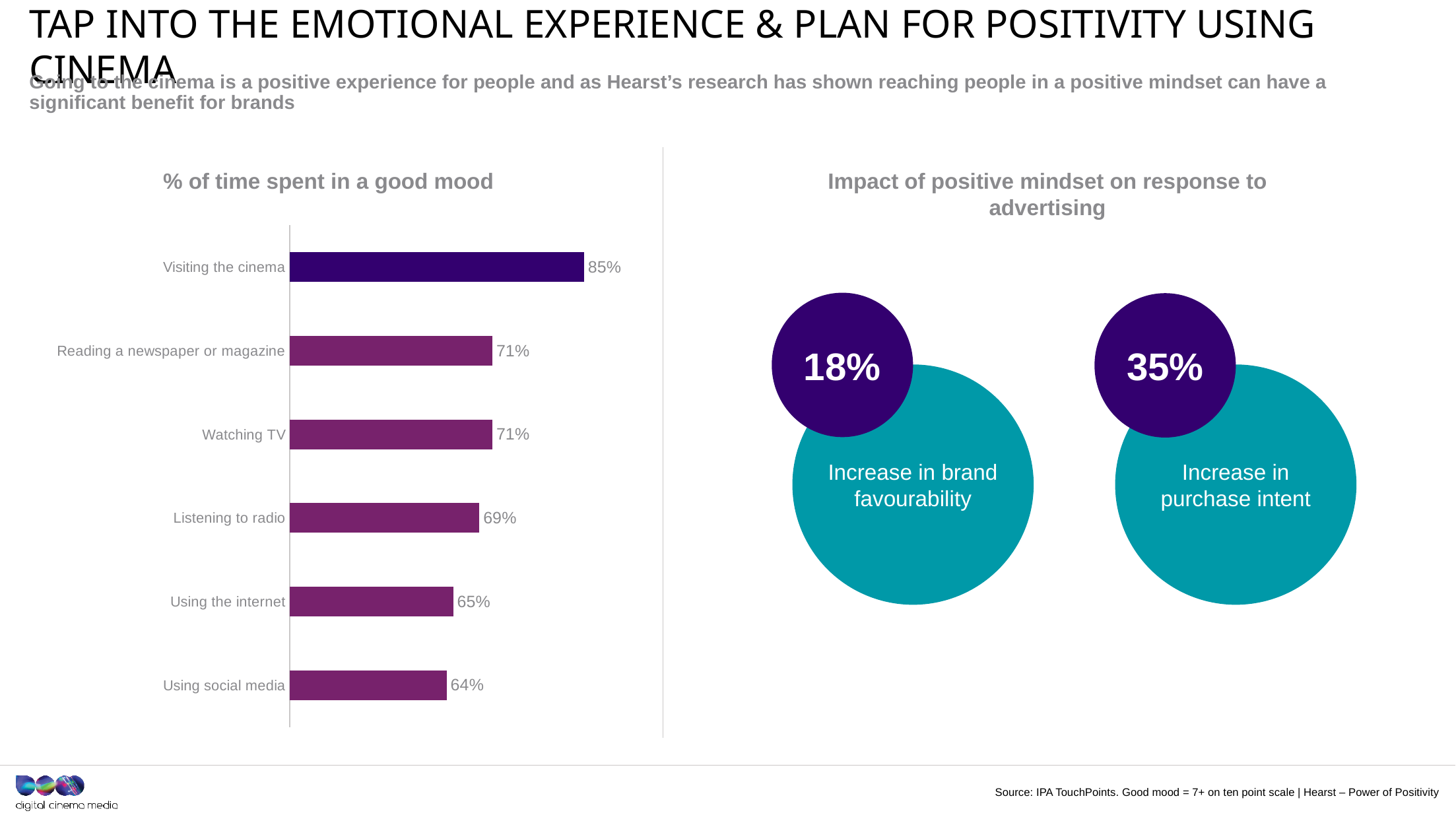
In the 'Impact of positive mindset on response to advertising' chart, what is the increase in brand favourability? 18% In the '% of time spent in a good mood' chart, what is the value for Using the internet? 65% In the '% of time spent in a good mood' chart, what is the difference between Visiting the cinema and Watching TV? 14 percentage points What kind of chart is the '% of time spent in a good mood' chart? Bar chart In the '% of time spent in a good mood' chart, what is the value for Using social media? 64% In the '% of time spent in a good mood' chart, what is the value for Visiting the cinema? 85% In the '% of time spent in a good mood' chart, which category has the lowest value? Using social media In the 'Impact of positive mindset on response to advertising' chart, what is the increase in purchase intent? 35% In the '% of time spent in a good mood' chart, which is larger: Listening to radio or Using the internet? Listening to radio In the '% of time spent in a good mood' chart, which category has the highest value? Visiting the cinema How many categories are shown in the '% of time spent in a good mood' chart? 6 In the '% of time spent in a good mood' chart, what is the value for Listening to radio? 69%